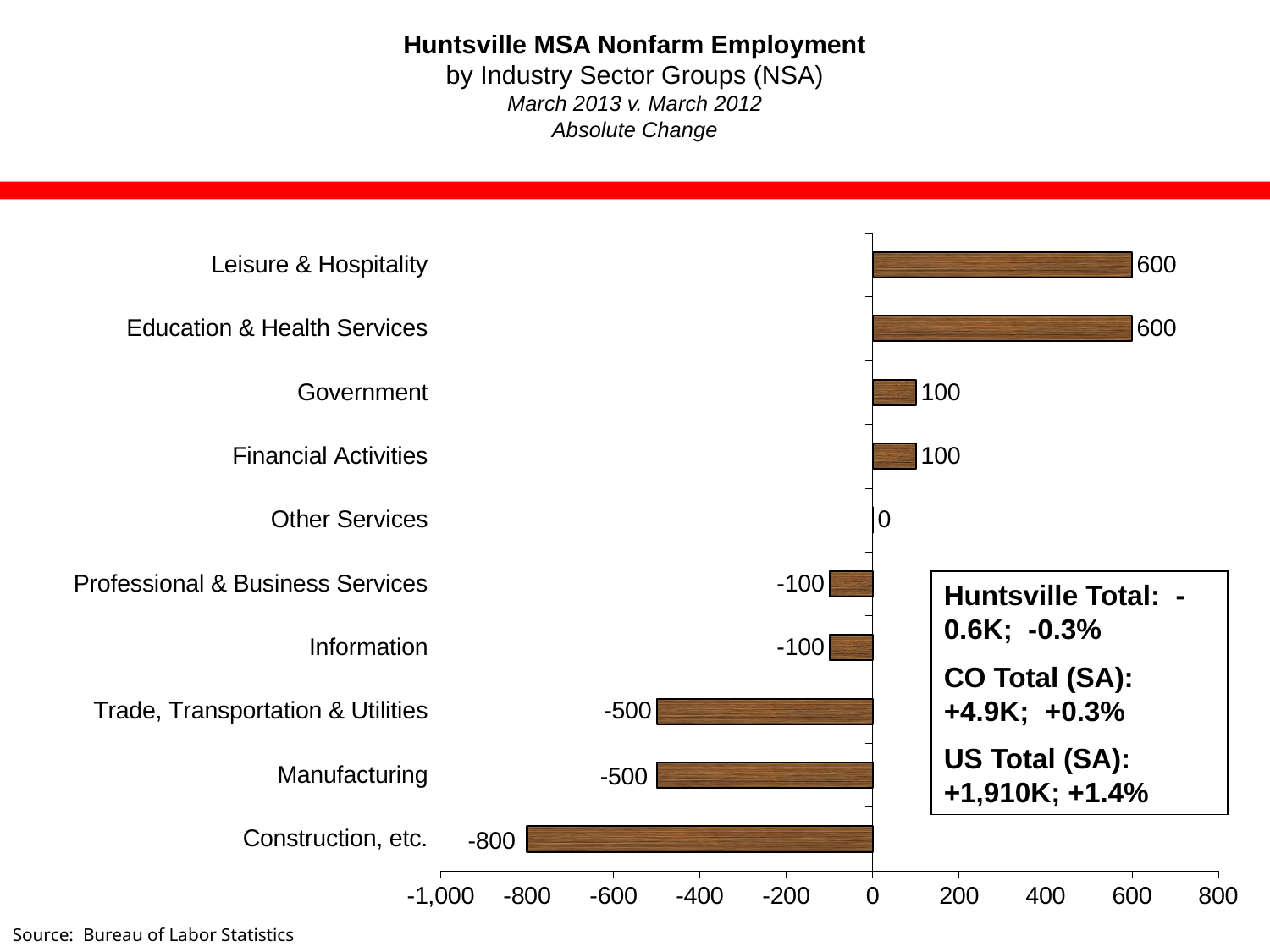
Is the value for Trade, Transportation & Utilities greater or less than -200? less What is the source cited for the chart? Bureau of Labor Statistics How many industry sector categories are shown on the chart? 10 What is the absolute change for Government? 100 What is the absolute change for Construction, etc.? -800 What is the absolute change for Manufacturing? -500 What is the Huntsville Total shown in the text box on the chart? -0.6K; -0.3% Which is larger, the value for Information or the value for Financial Activities? Financial Activities What kind of chart is shown on the slide? bar chart What is the difference between the values for Leisure & Hospitality and Government? 500 Which category has the lowest value? Construction, etc. What is the absolute change for Other Services? 0